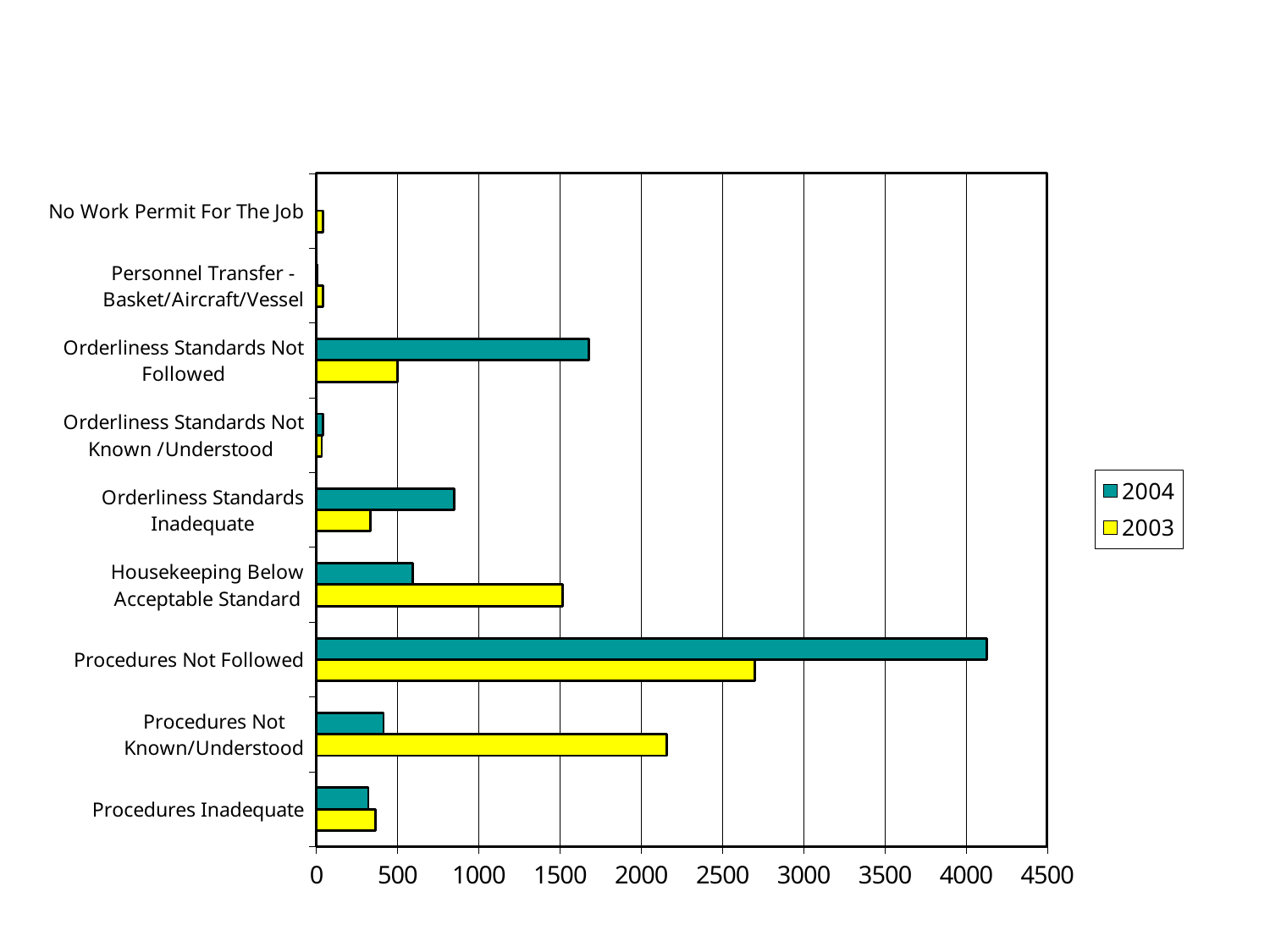
Which colour represents the 2003 series in the legend? yellow Is the 2003 value for Procedures Not Known/Understood greater or less than 2000? greater Is the 2004 value for Procedures Not Followed greater or less than 4000? greater What kind of chart is shown on the slide? bar chart How many categories are shown on the chart? 9 Is the 2004 value for Orderliness Standards Inadequate greater or less than 1000? less Which category has the highest value for 2003? Procedures Not Followed For Orderliness Standards Not Followed, which year has the larger value, 2003 or 2004? 2004 How many series does the legend list? 2 Which category has the highest value for 2004? Procedures Not Followed For Housekeeping Below Acceptable Standard, which year has the larger value, 2003 or 2004? 2003